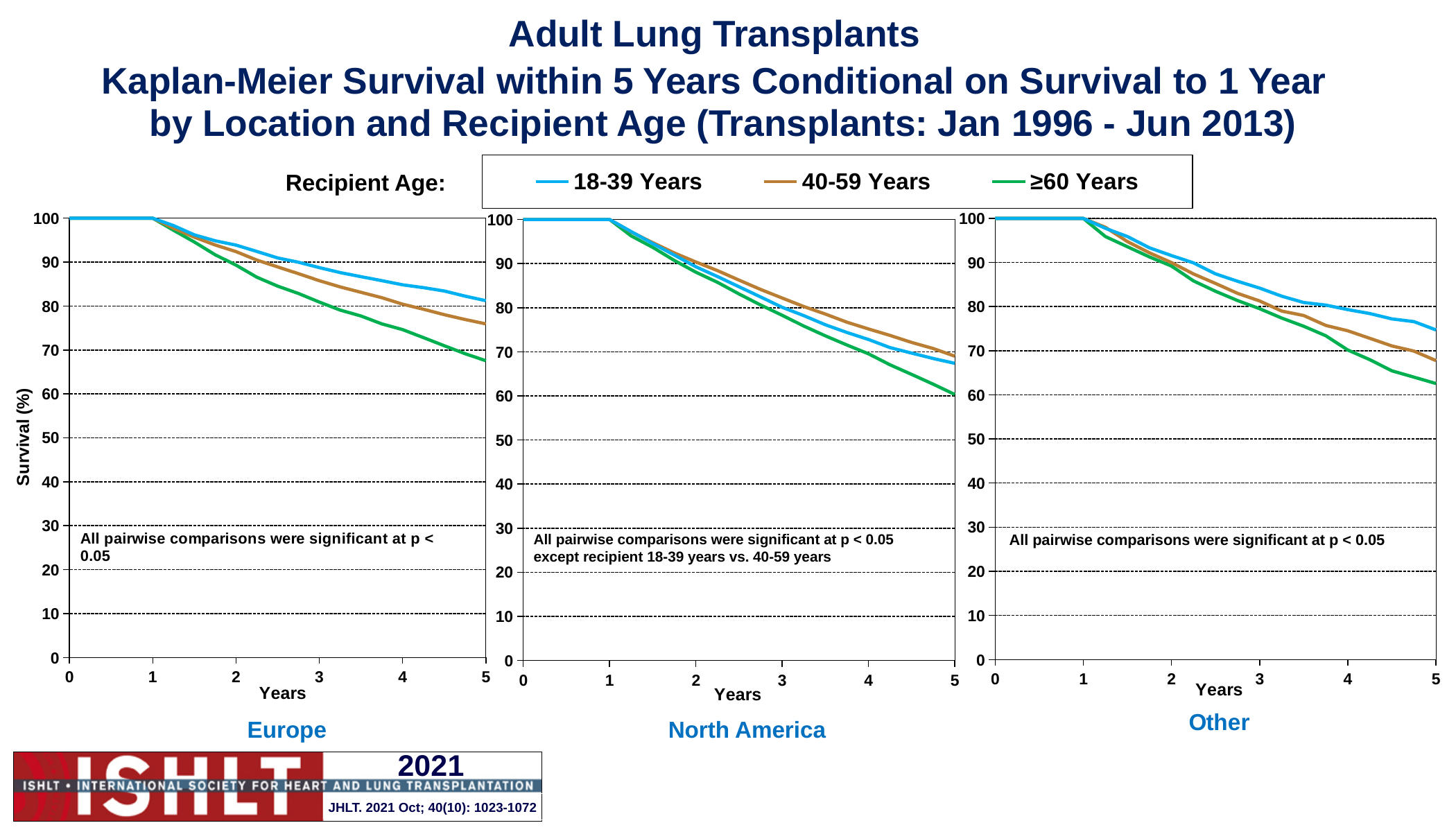
In the Other chart, is the survival for 18-39 Years at 5 years greater or less than 70? greater In the Europe chart, which recipient age group has the highest survival at 5 years? 18-39 Years In the North America chart, does survival for the ≥60 Years group rise or fall from year 1 to year 5? fall In the Other chart, at 5 years, which is larger: survival for 40-59 Years or ≥60 Years? 40-59 Years In the Europe chart, which recipient age group has the lowest survival at 5 years? ≥60 Years How many recipient age groups does the legend list? 3 In the North America chart, which recipient age group has the lowest survival at 5 years? ≥60 Years What kind of chart is the Europe chart? line chart Which colour represents the 40-59 Years group in the legend? brown In the Other chart, which recipient age group has the highest survival at 5 years? 18-39 Years In the North America chart, is the survival for 18-39 Years at 5 years greater or less than 70? less In the Europe chart, is the survival for ≥60 Years at 5 years greater or less than 70? less